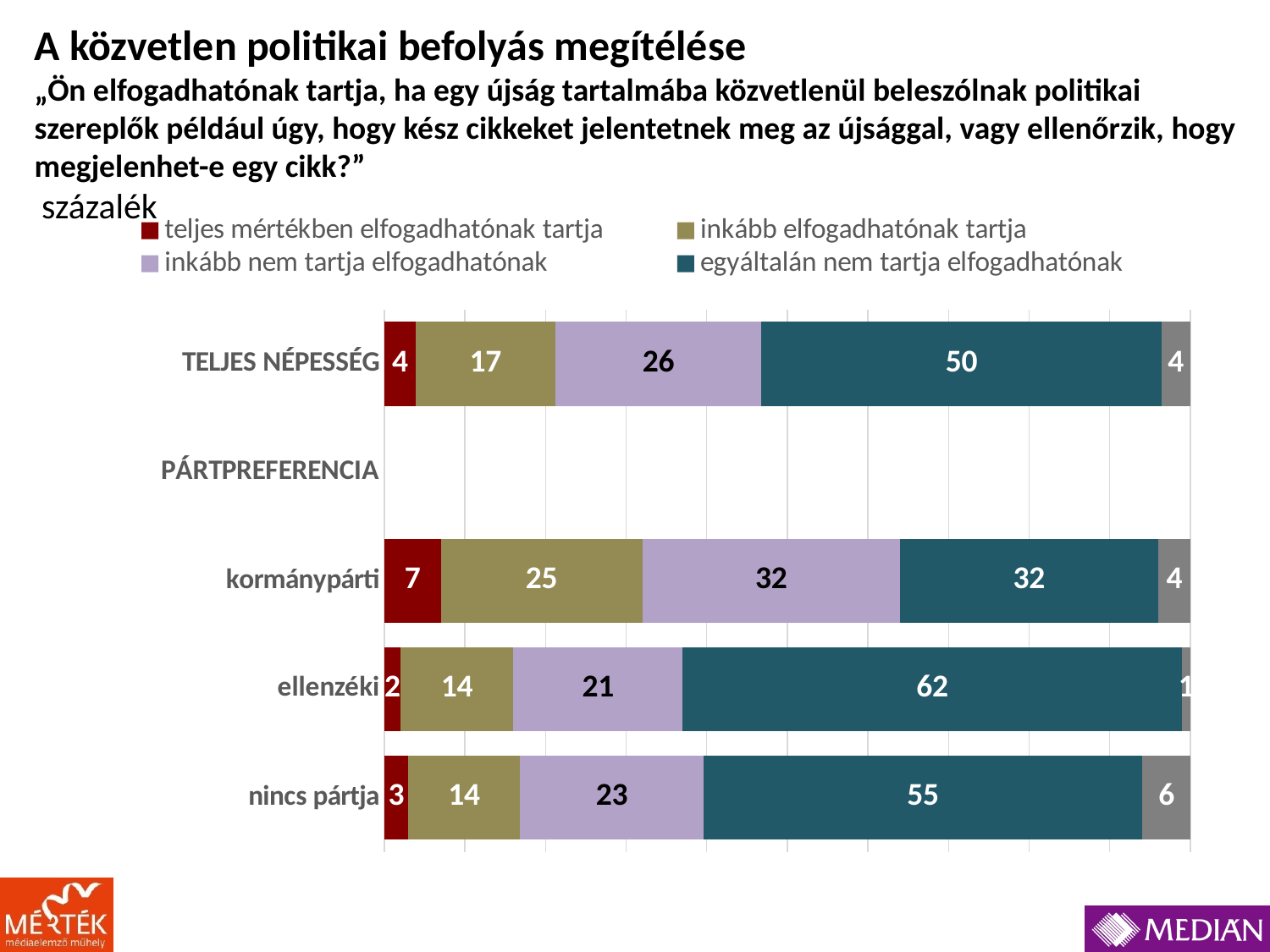
What is the value for 'teljes mértékben elfogadhatónak tartja' in the nincs pártja bar? 3 Which is larger: the 'egyáltalán nem tartja elfogadhatónak' value for nincs pártja or for kormánypárti? nincs pártja Which legend entry is shown in dark red? teljes mértékben elfogadhatónak tartja What is the value for 'egyáltalán nem tartja elfogadhatónak' in the TELJES NÉPESSÉG bar? 50 Which group has the highest value for 'egyáltalán nem tartja elfogadhatónak'? ellenzéki How many groups have bars plotted in the chart? 4 What kind of chart is shown on the slide? stacked bar chart How many series does the legend list? 4 What is the value for 'inkább nem tartja elfogadhatónak' in the ellenzéki bar? 21 Which group has the lowest value for 'teljes mértékben elfogadhatónak tartja'? ellenzéki What is the difference between the kormánypárti and ellenzéki values for 'inkább elfogadhatónak tartja'? 11 What is the value for 'inkább elfogadhatónak tartja' in the kormánypárti bar? 25